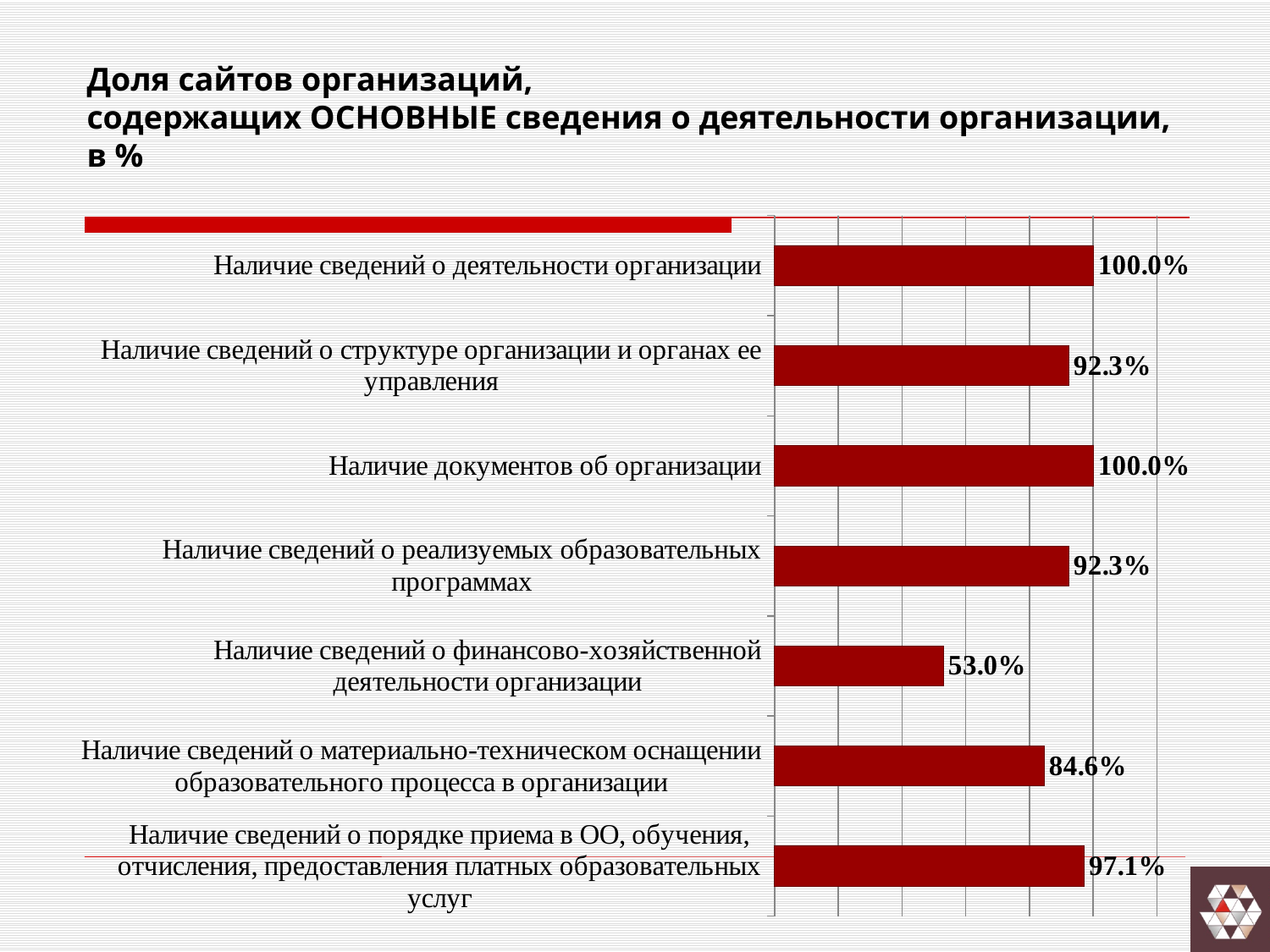
What colour are the bars in the chart? dark red What is the difference between the value for "Наличие сведений о деятельности организации" and the value for "Наличие сведений о финансово-хозяйственной деятельности организации"? 47.0 percentage points What is the value for "Наличие сведений о структуре организации и органах ее управления"? 92.3% What kind of chart is shown on the slide? bar chart What is the value for "Наличие документов об организации"? 100.0% What is the value for "Наличие сведений о материально-техническом оснащении образовательного процесса в организации"? 84.6% Which category has the lowest value? Наличие сведений о финансово-хозяйственной деятельности организации What is the highest value shown in the chart? 100.0% What is the value for "Наличие сведений о финансово-хозяйственной деятельности организации"? 53.0% Which is larger: the value for "Наличие сведений о порядке приема в ОО, обучения, отчисления, предоставления платных образовательных услуг" or the value for "Наличие сведений о материально-техническом оснащении образовательного процесса в организации"? Наличие сведений о порядке приема в ОО, обучения, отчисления, предоставления платных образовательных услуг What is the value for "Наличие сведений о порядке приема в ОО, обучения, отчисления, предоставления платных образовательных услуг"? 97.1% How many categories are plotted in the chart? 7